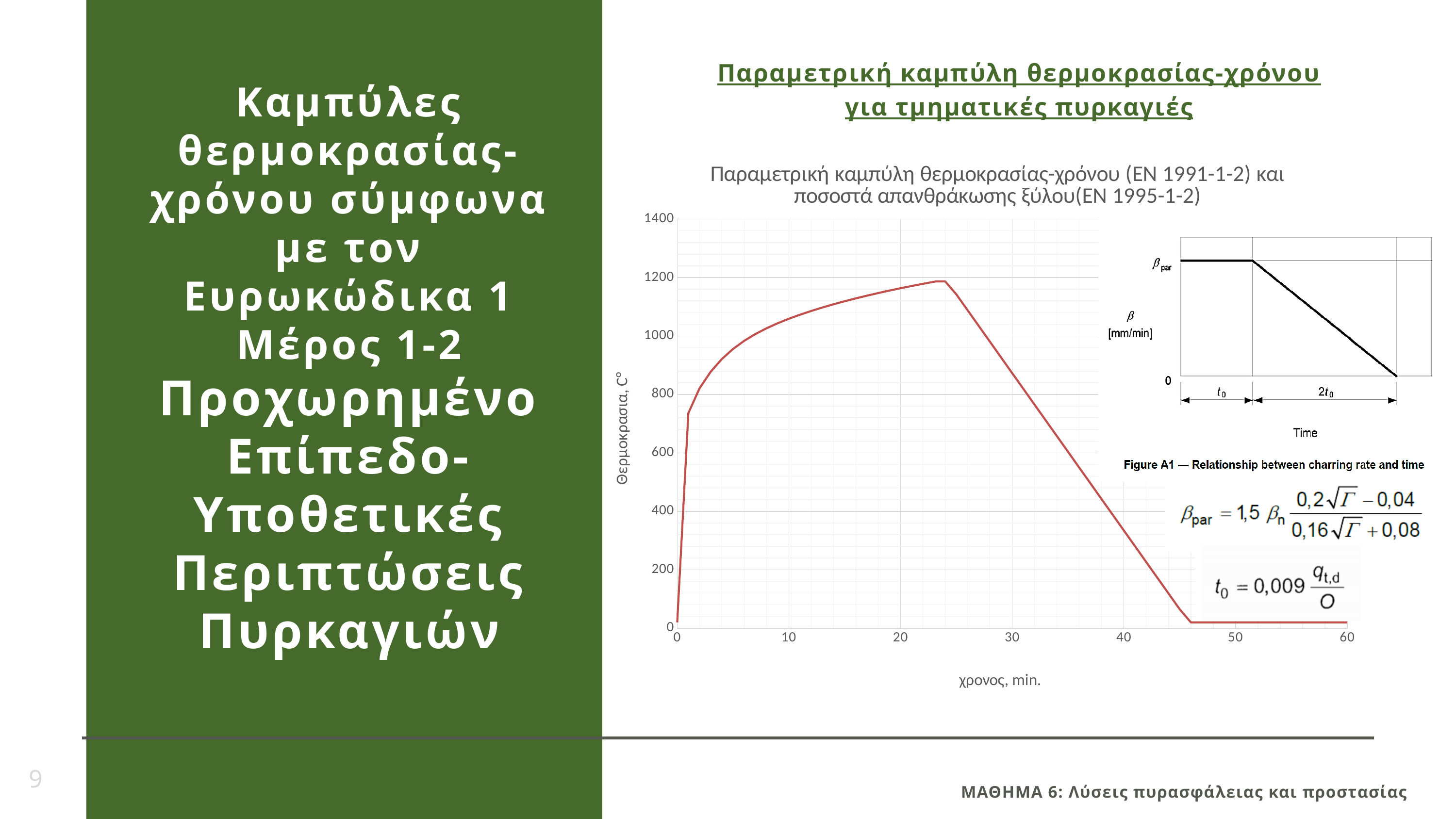
Does the temperature rise or fall between 30 and 40 min? fall Is the temperature at 20 min greater or less than 1000? greater Is the temperature at 30 min greater or less than 1000? less Is the temperature at 50 min greater or less than 200? less Which is larger, the temperature at 20 min or the temperature at 40 min? 20 min What is the label of the vertical axis of the chart? Θερμοκρασία, C° How many lines (series) are plotted on the chart? 1 What is the title of the chart on the slide? Παραμετρική καμπύλη θερμοκρασίας-χρόνου (EN 1991-1-2) και ποσοστά απανθράκωσης ξύλου(EN 1995-1-2) What kind of chart is shown on the slide? line chart Does the temperature rise or fall between 0 and 20 min? rise